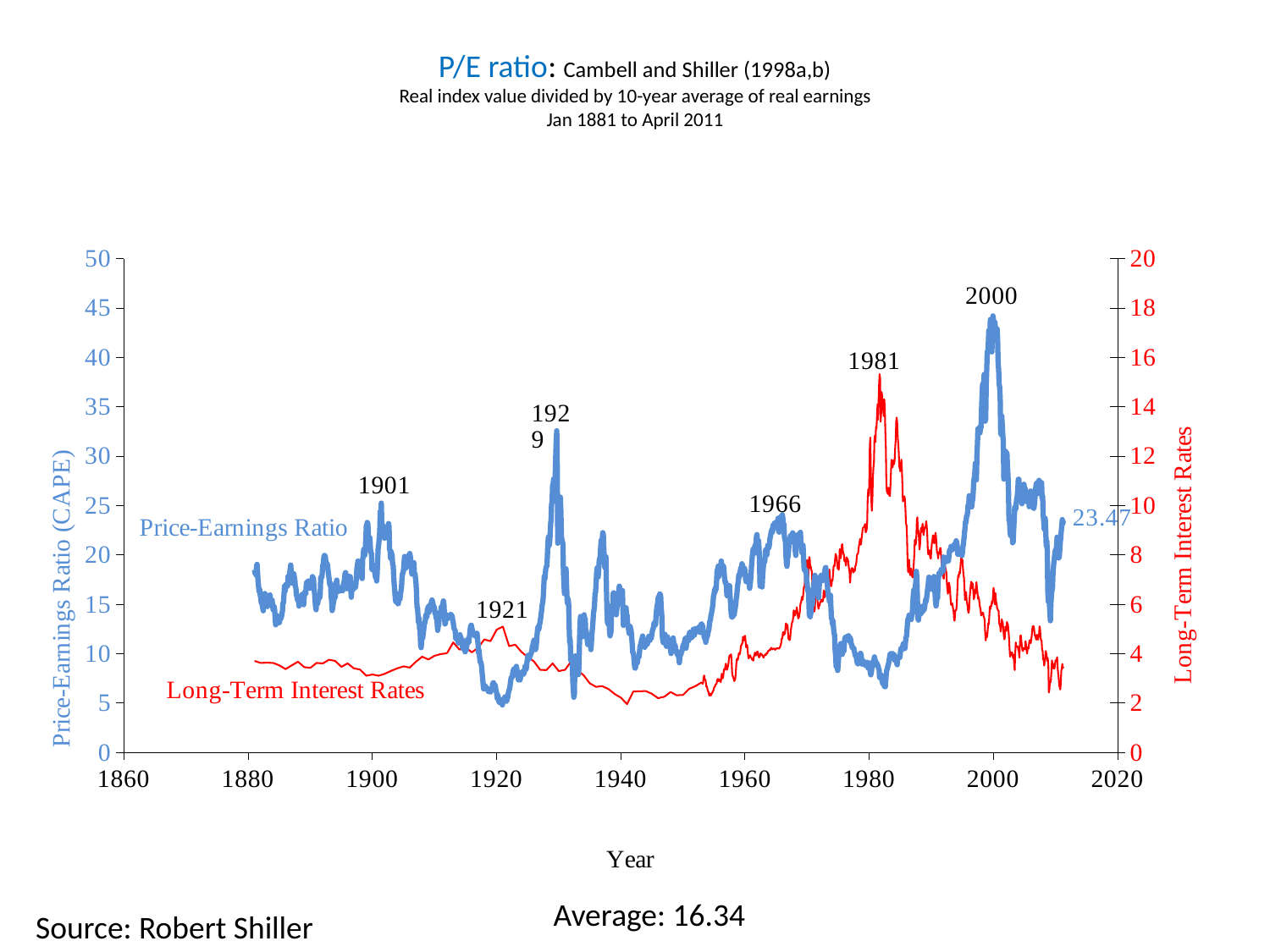
What colour is the Price-Earnings Ratio line? blue How many data series are plotted on the chart? 2 What kind of chart is shown on the slide? line chart In which annotated year do Long-Term Interest Rates reach their highest peak? 1981 Is the Price-Earnings Ratio peak in 2000 greater or less than 40? greater Is the Long-Term Interest Rate peak in 1981 greater or less than 12? greater What average value is stated below the chart? 16.34 Is the Price-Earnings Ratio around 1920 greater or less than 10? less In which annotated year does the Price-Earnings Ratio reach its highest peak? 2000 What is the final value of the Price-Earnings Ratio labelled at the right end of the blue line? 23.47 Which Price-Earnings Ratio peak is higher, 1929 or 2000? 2000 Does the Price-Earnings Ratio rise or fall between 1981 and 2000? rise